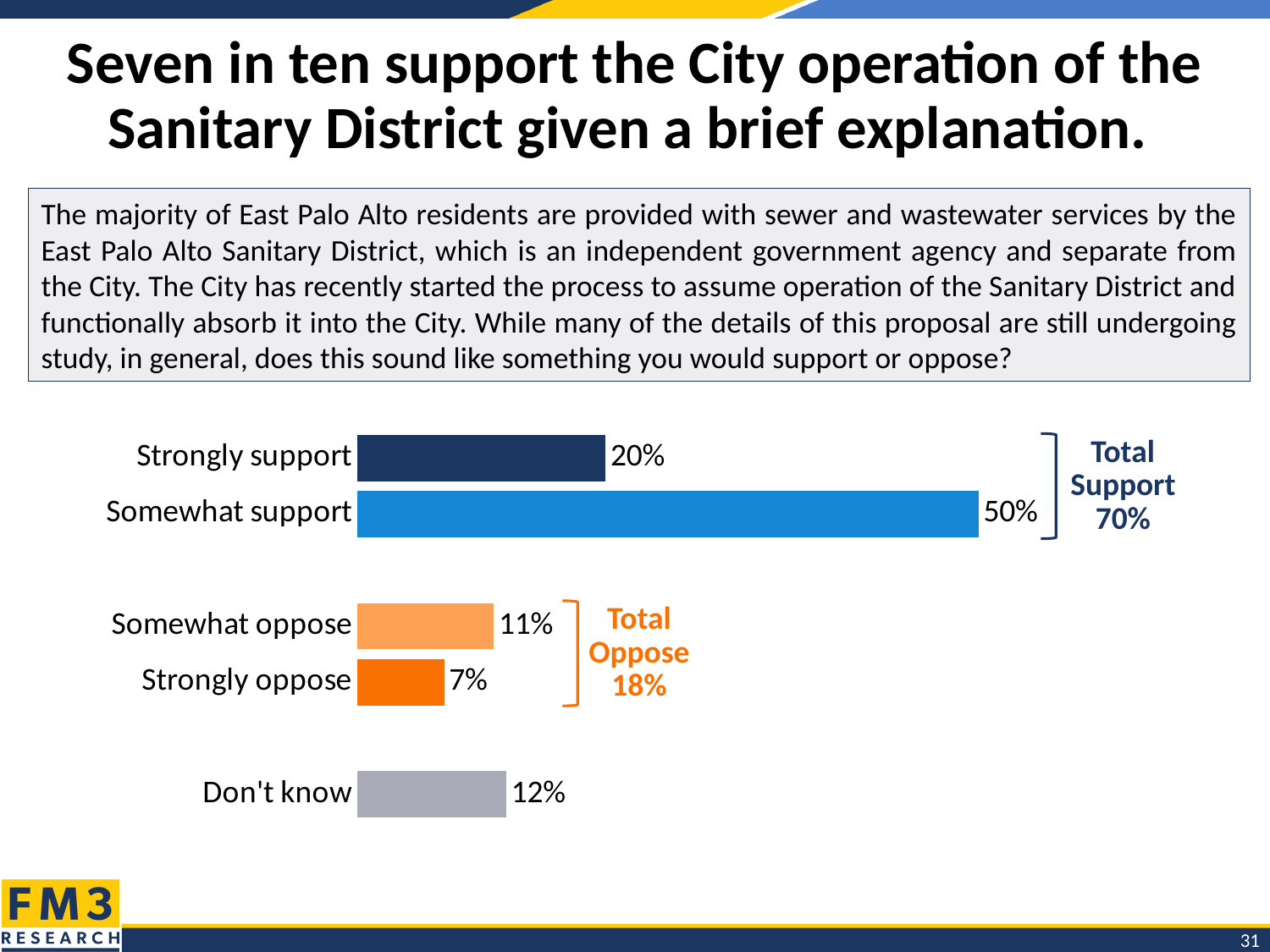
What percentage of respondents said they somewhat support the proposal? 50% Which response category has the lowest percentage? Strongly oppose What percentage of respondents said they somewhat oppose the proposal? 11% Which is larger: the percentage who somewhat oppose or the percentage who answered "Don't know"? Don't know What is the difference between the percentage who somewhat support and the percentage who strongly support? 30% What percentage of respondents answered "Don't know"? 12% What percentage of respondents said they strongly oppose the proposal? 7% What percentage of respondents said they strongly support the City operation of the Sanitary District? 20% Which response category has the highest percentage? Somewhat support What kind of chart is shown on the slide? Bar chart What is the total oppose percentage shown on the chart? 18% What is the total support percentage shown on the chart? 70%